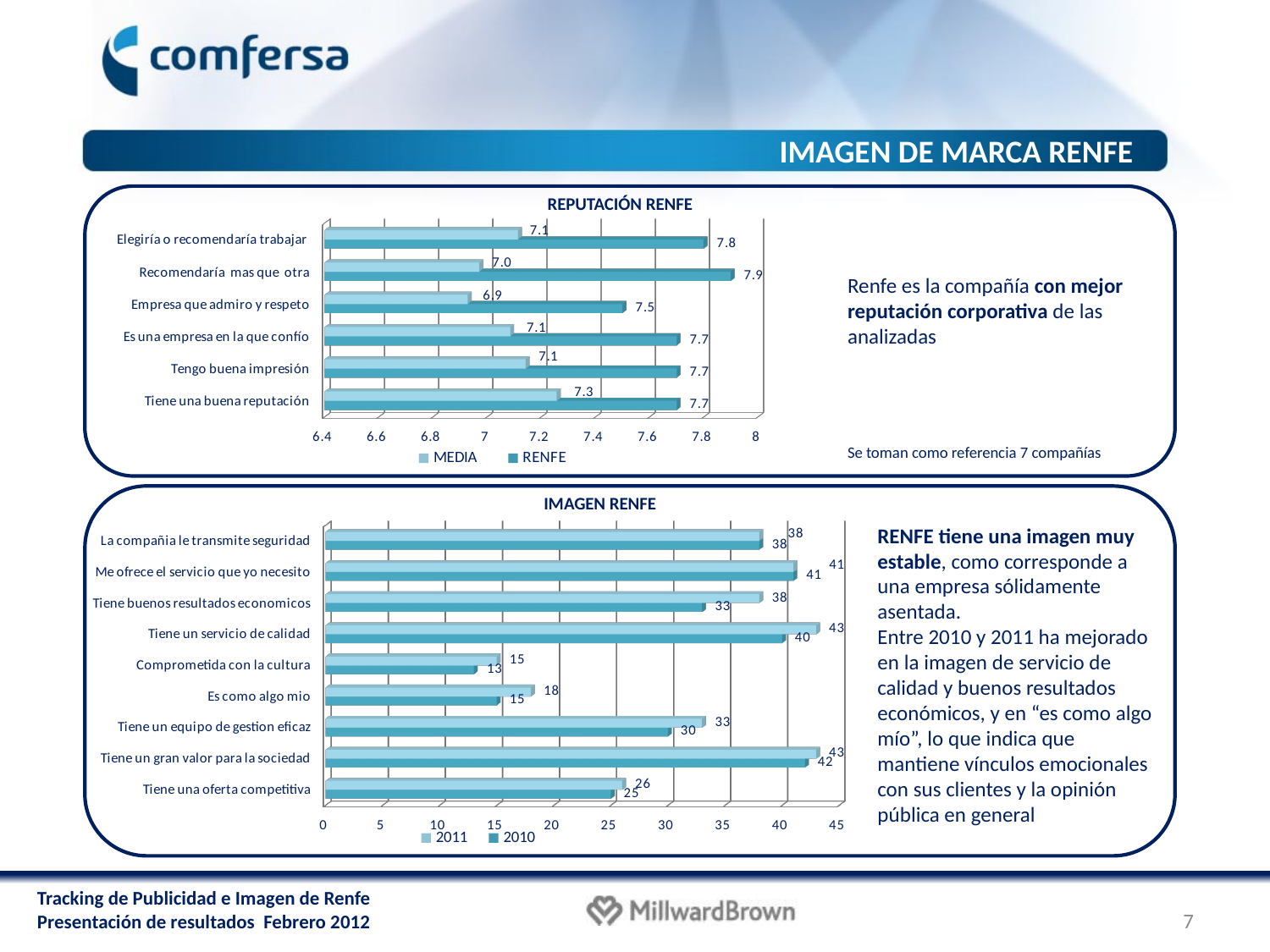
In the REPUTACIÓN RENFE chart, what is the difference between the RENFE and MEDIA values for "Recomendaría mas que otra"? 0.9 In the REPUTACIÓN RENFE chart, how many categories are shown? 6 In the REPUTACIÓN RENFE chart, which series does the legend list besides MEDIA? RENFE In the IMAGEN RENFE chart, which is larger for "Es como algo mio": the 2011 value or the 2010 value? 2011 In the REPUTACIÓN RENFE chart, which category has the lowest RENFE value? Empresa que admiro y respeto In the IMAGEN RENFE chart, which category has the lowest 2010 value? Comprometida con la cultura In the IMAGEN RENFE chart, what is the 2011 value for "Tiene un servicio de calidad"? 43 In the IMAGEN RENFE chart, what is the 2010 value for "Tiene buenos resultados economicos"? 33 In the REPUTACIÓN RENFE chart, what is the RENFE value for "Recomendaría mas que otra"? 7.9 What type of chart is the IMAGEN RENFE chart? Bar chart In the REPUTACIÓN RENFE chart, what is the MEDIA value for "Tiene una buena reputación"? 7.3 In the IMAGEN RENFE chart, what is the difference between the 2011 and 2010 values for "Tiene buenos resultados economicos"? 5